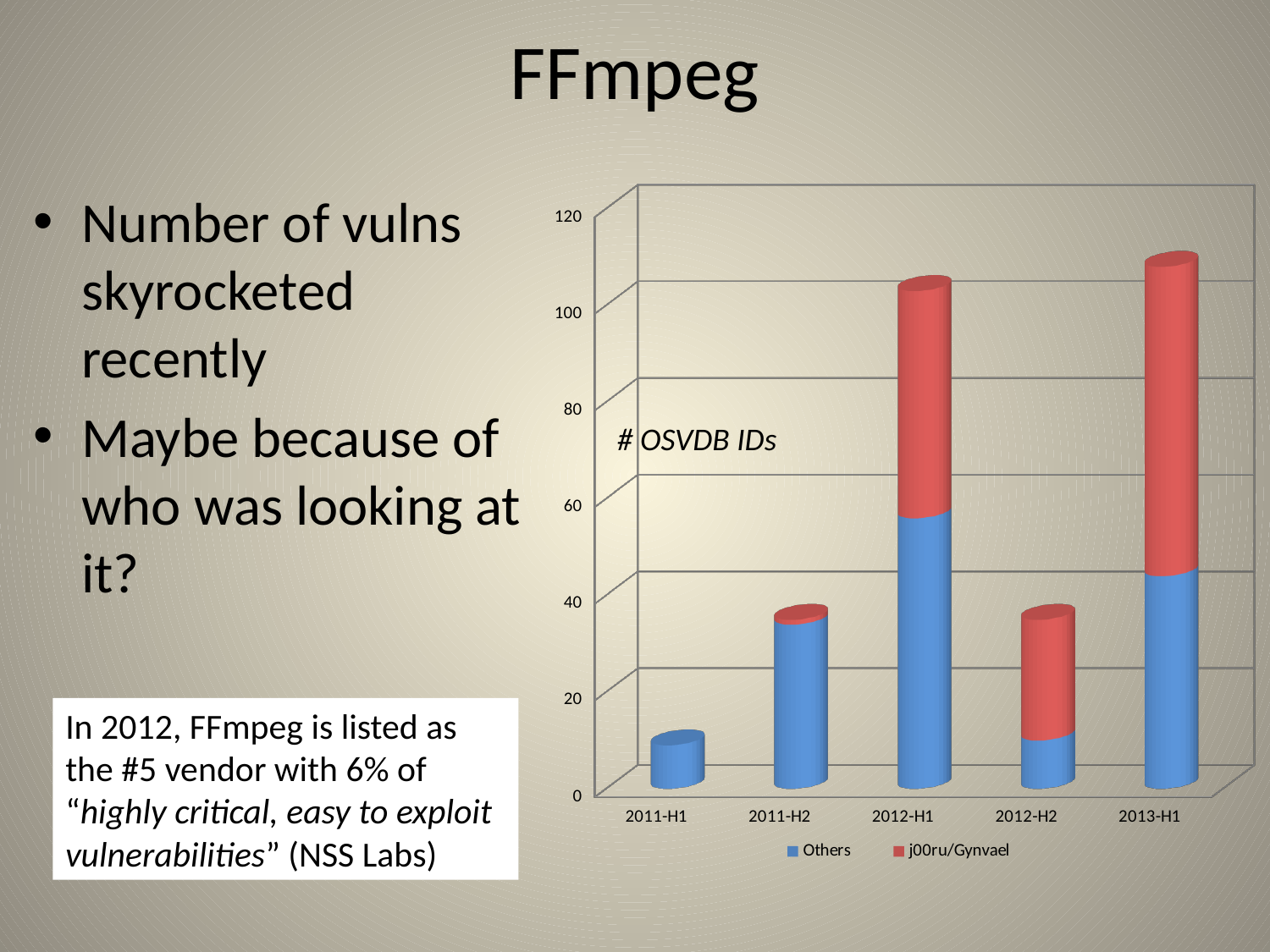
Which is larger, the Others value for 2012-H1 or the Others value for 2013-H1? 2012-H1 How many series does the chart legend list? 2 What does the label inside the chart say the values represent? # OSVDB IDs Is the Others value for 2012-H1 greater or less than 40? greater How many time periods are shown on the x axis of the chart? 5 Is the total value for 2012-H1 greater or less than 80? greater Is the total value for 2011-H1 greater or less than 20? less Which is larger, the j00ru/Gynvael value for 2012-H1 or the j00ru/Gynvael value for 2013-H1? 2013-H1 Which period has the lowest total number of OSVDB IDs? 2011-H1 What kind of chart is shown on the slide? Stacked bar chart